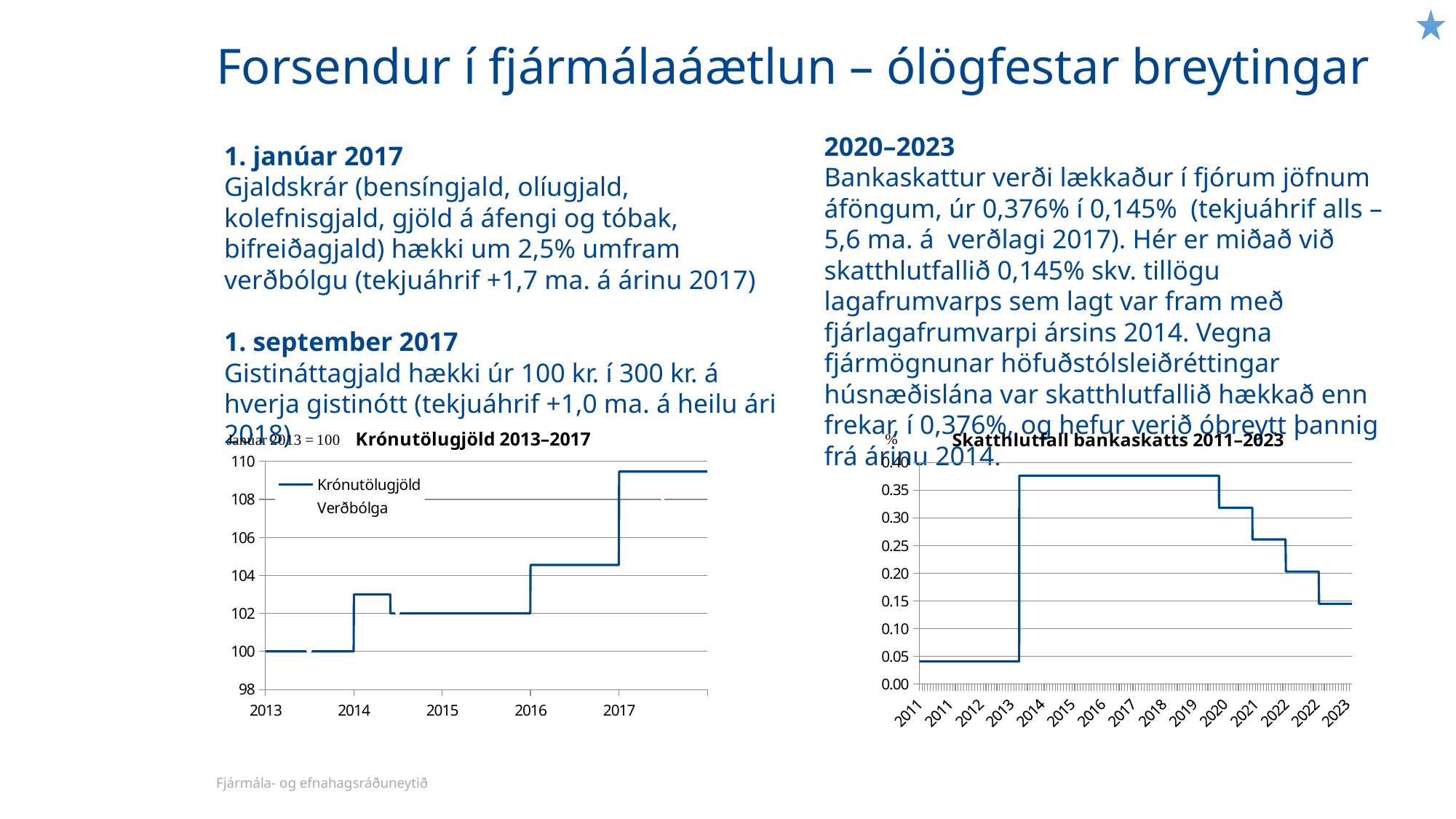
In the 'Krónutölugjöld 2013–2017' chart, what are the two legend entries? Krónutölugjöld and Verðbólga In the 'Skatthlutfall bankaskatts 2011–2023' chart, is the value in 2011 greater or less than 0.05? less In the 'Krónutölugjöld 2013–2017' chart, is the Krónutölugjöld value at the start of 2017 greater or less than 108? greater In the 'Skatthlutfall bankaskatts 2011–2023' chart, do the values rise or fall from 2019 to 2023? fall What kind of chart is the 'Skatthlutfall bankaskatts 2011–2023' chart? line chart In the 'Skatthlutfall bankaskatts 2011–2023' chart, is the value in 2016 greater or less than 0.35? greater In the 'Skatthlutfall bankaskatts 2011–2023' chart, which is larger: the value in 2018 or the value in 2023? 2018 What kind of chart is the 'Krónutölugjöld 2013–2017' chart? line chart In the 'Krónutölugjöld 2013–2017' chart, which is larger for Krónutölugjöld: the value in 2013 or the value in 2017? 2017 In the 'Krónutölugjöld 2013–2017' chart, do the Krónutölugjöld values rise or fall from 2013 to 2017? rise How many series does the legend of the 'Krónutölugjöld 2013–2017' chart list? 2